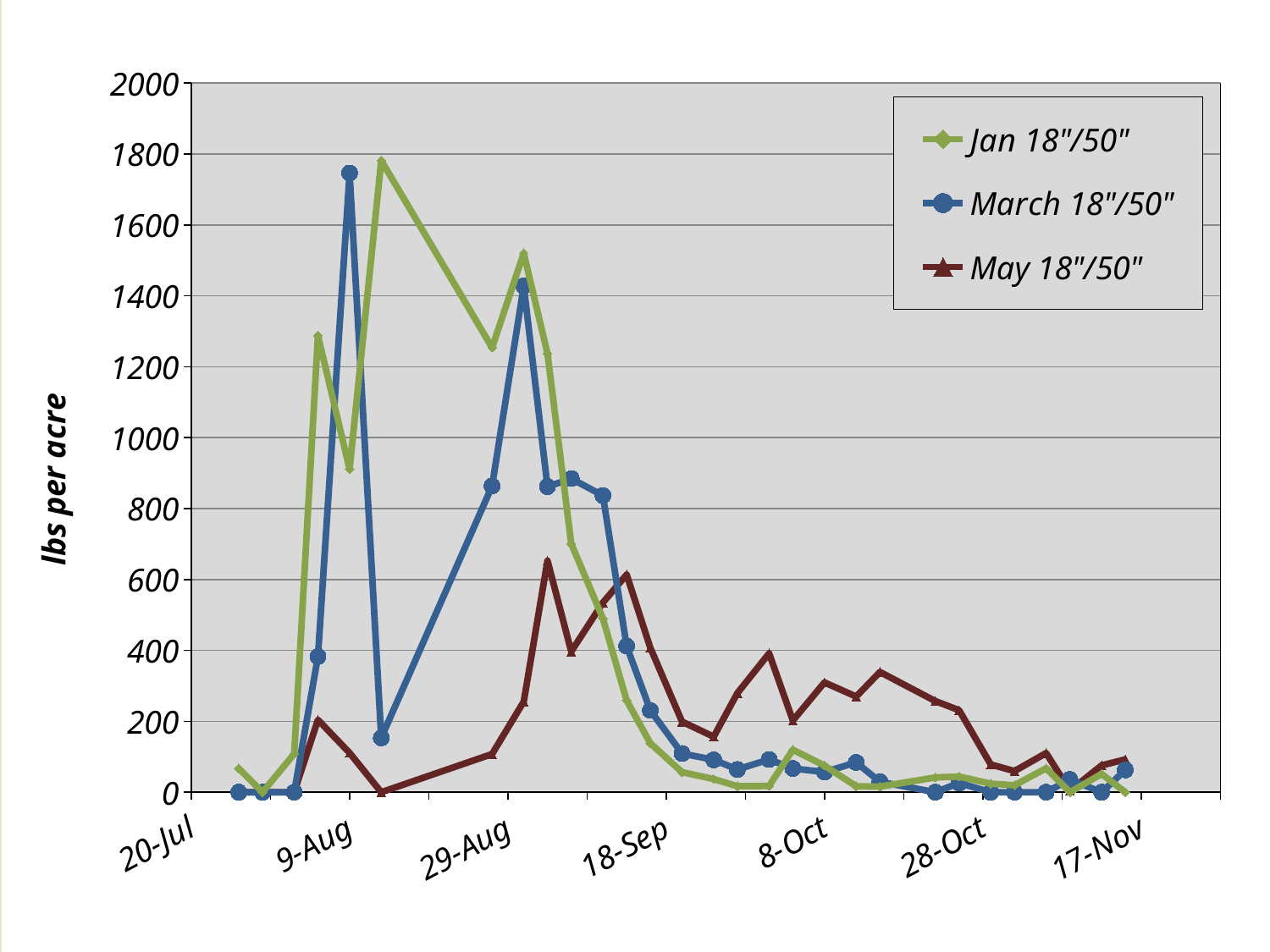
Around 8-Oct, which series is higher, May 18"/50" or March 18"/50"? May 18"/50" How many series does the legend list? 3 What is the label on the vertical axis? lbs per acre Which series has the lowest peak value? May 18"/50" What are the three series named in the legend? Jan 18"/50", March 18"/50", May 18"/50" Is the highest value reached by the March 18"/50" series greater or less than 1600? greater Between 29-Aug and 18-Sep, do the Jan 18"/50" values generally rise or fall? fall Is the highest value reached by the Jan 18"/50" series greater or less than 1600? greater Is the highest value reached by the May 18"/50" series greater or less than 800? less What kind of chart is shown on the slide? line chart